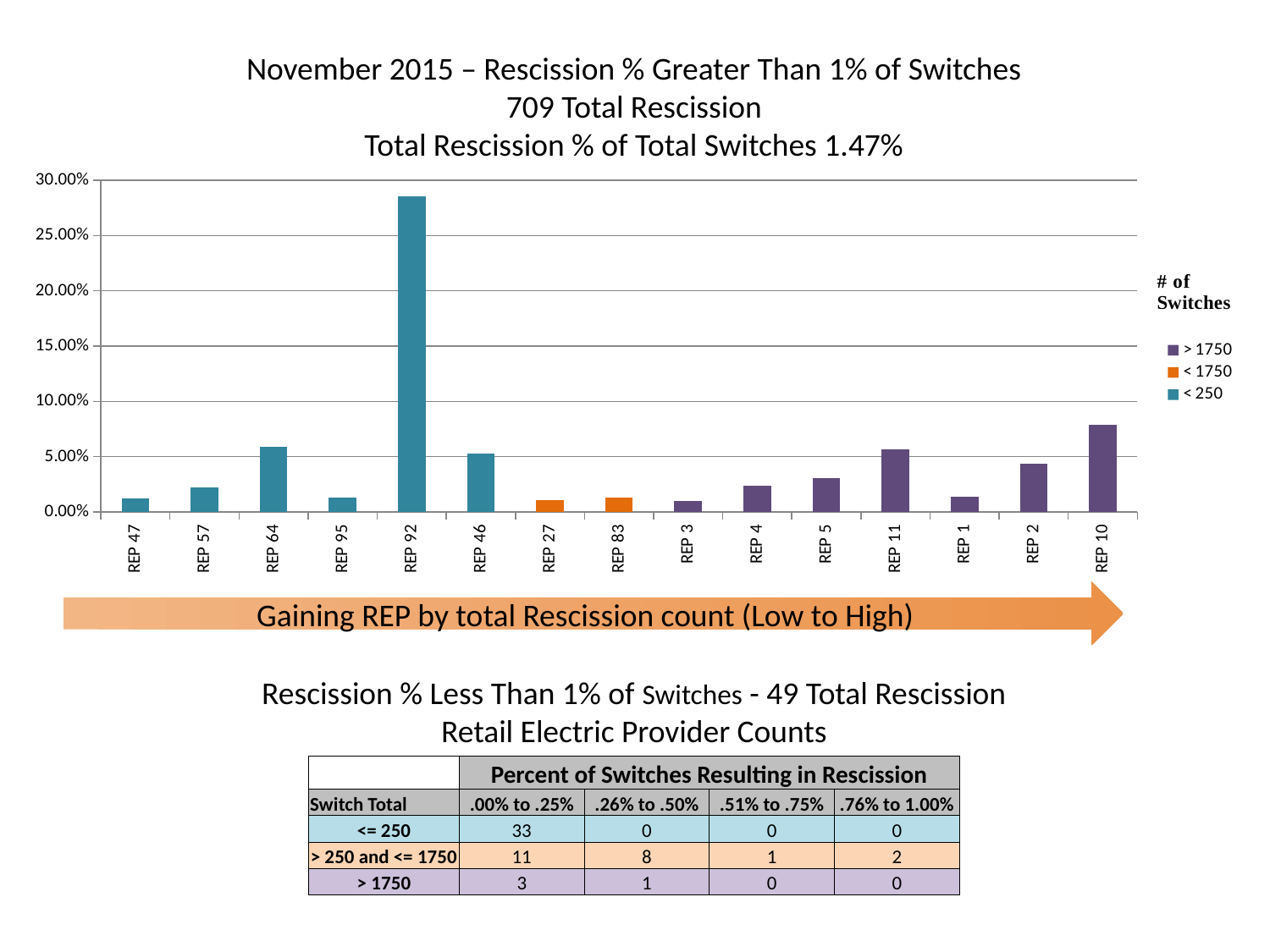
How many REPs are plotted along the x axis of the chart? 15 Which has the larger rescission percentage, REP 64 or REP 57? REP 64 Is the value for REP 5 greater or less than 5.00%? less Which legend series does the bar for REP 92 belong to? < 250 Is the value for REP 92 greater or less than 25.00%? greater Which has the larger rescission percentage, REP 92 or REP 10? REP 92 Is the value for REP 4 greater or less than 5.00%? less How many series does the chart legend list? 3 Which REP has the highest rescission percentage in the chart? REP 92 What is the title of the chart legend? # of Switches What kind of chart is shown on the slide? bar chart